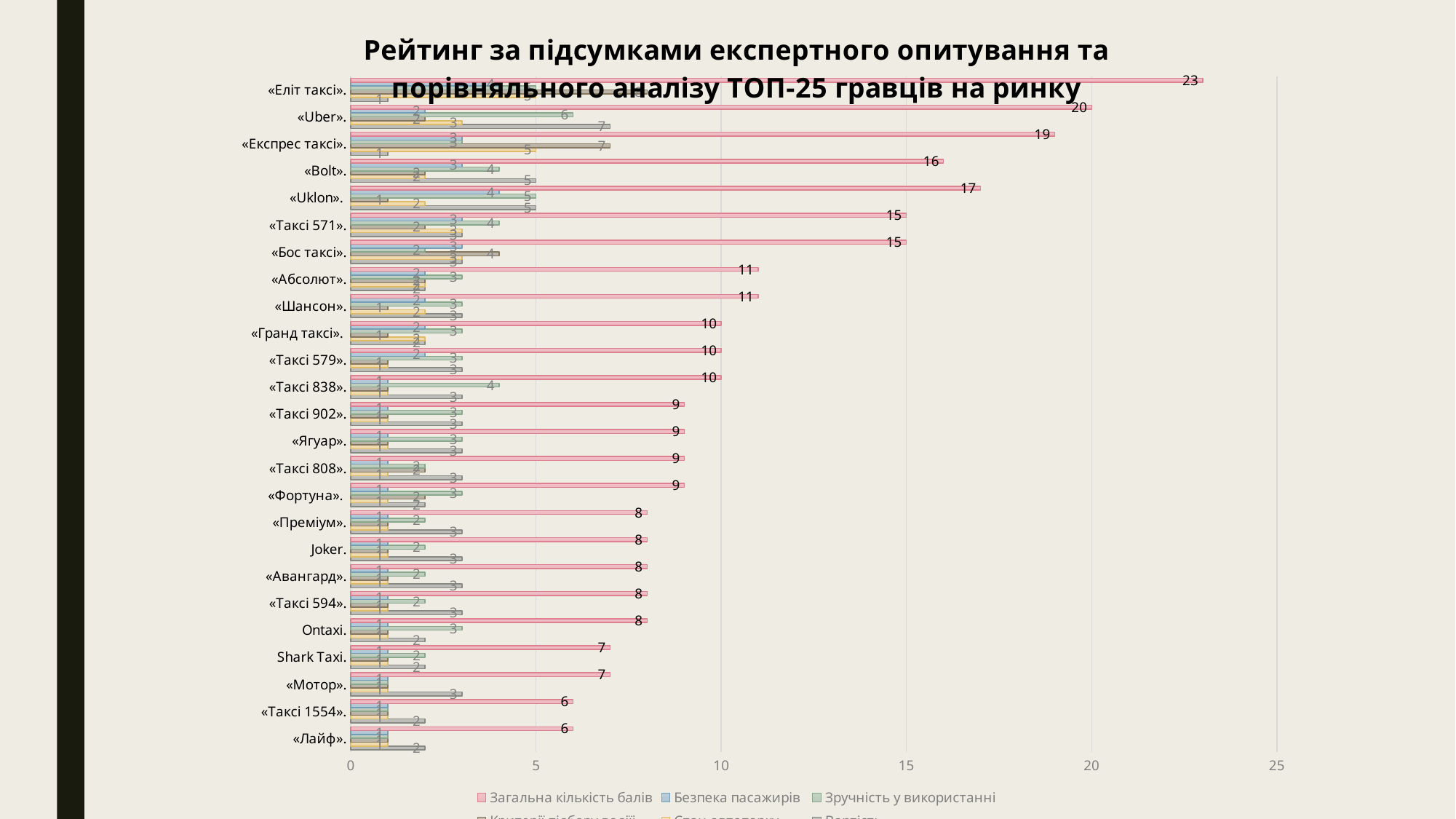
What is the total score (Загальна кількість балів) for Shark Taxi? 7 Which series is shown in pink according to the legend? Загальна кількість балів What type of chart is shown on the slide? Bar chart What is the total score (Загальна кількість балів) for «Абсолют»? 11 How many companies are listed on the chart? 25 What is the lowest total score (Загальна кількість балів) shown on the chart? 6 What is the difference between the total scores of «Еліт таксі» and «Uber»? 3 What is the total score (Загальна кількість балів) for «Uklon»? 17 Which has a higher total score (Загальна кількість балів), «Bolt» or «Uklon»? «Uklon» What is the total score (Загальна кількість балів) for «Еліт таксі»? 23 What is the total score (Загальна кількість балів) for «Uber»? 20 Which company has the highest total score (Загальна кількість балів)? «Еліт таксі»